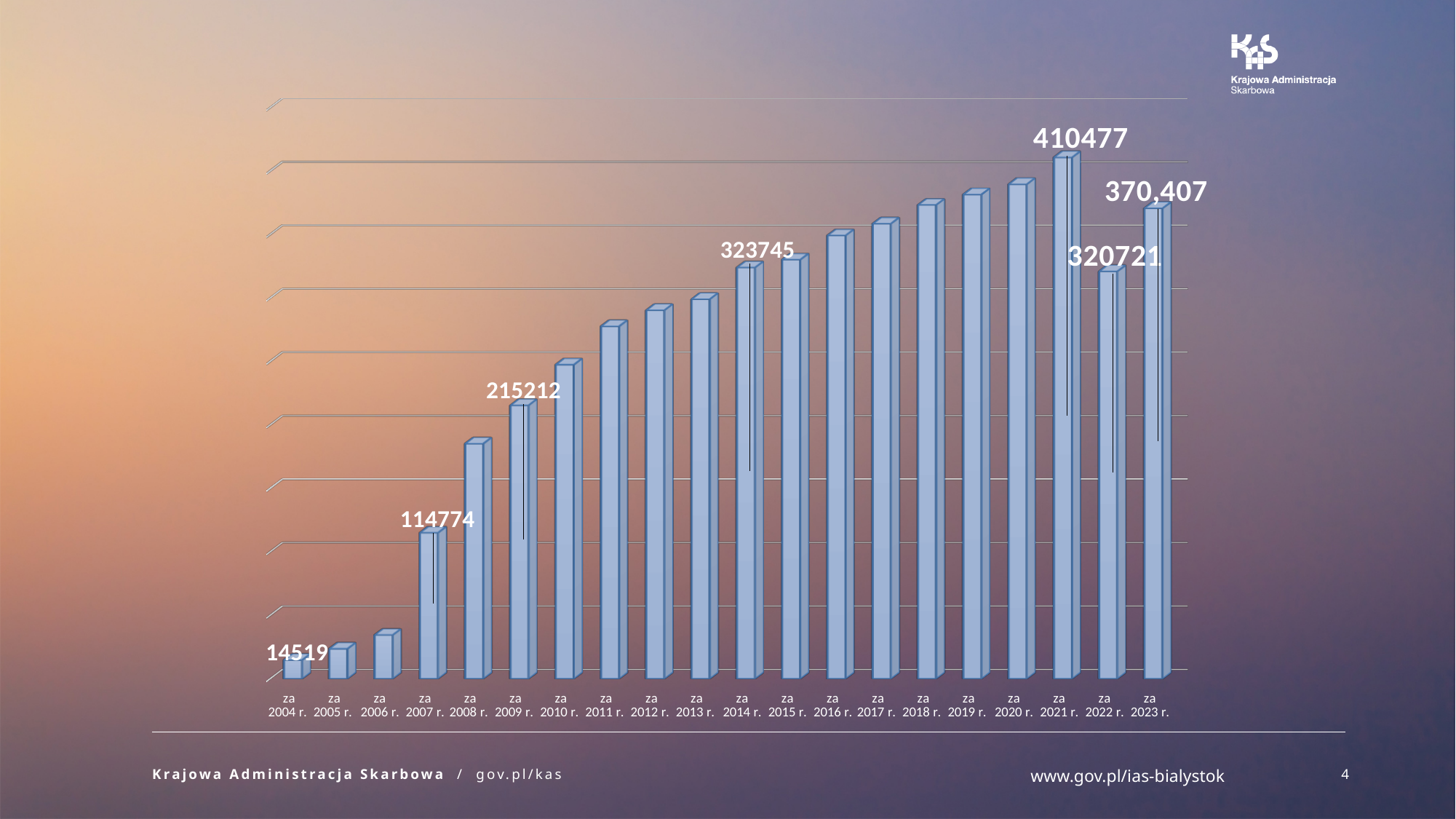
What is the value for za 2004 r.? 14519 Which is larger, the value for za 2022 r. or the value for za 2023 r.? za 2023 r. What kind of chart is shown on the slide? Bar chart What is the value for za 2007 r.? 114774 What is the value for za 2009 r.? 215212 What is the value for za 2014 r.? 323745 What is the value for za 2023 r.? 370,407 Which year has the highest bar? za 2021 r. What is the value for za 2021 r.? 410477 What is the difference between the values for za 2021 r. and za 2022 r.? 89756 Which year has the lowest bar? za 2004 r. How many years are shown on the x axis? 20